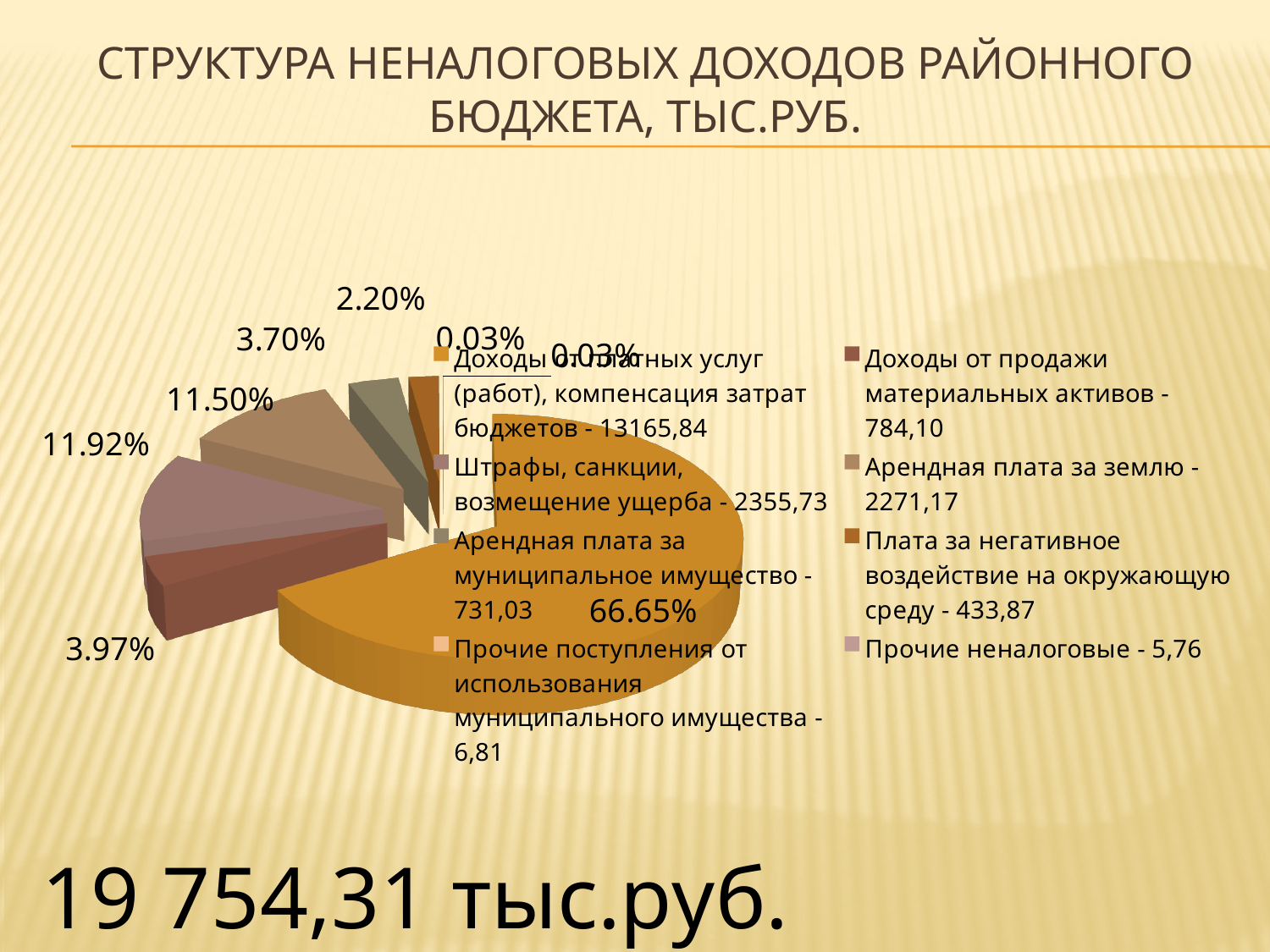
Which category has the smallest value in the legend? Прочие неналоговые - 5,76 What value is given in the legend for Штрафы, санкции, возмещение ущерба? 2355,73 How many categories does the legend of the pie chart list? 8 What is the title of the chart on the slide? Структура неналоговых доходов районного бюджета, тыс.руб. What value is given in the legend for Плата за негативное воздействие на окружающую среду? 433,87 Which category has the largest slice of the pie chart? Доходы от платных услуг (работ), компенсация затрат бюджетов What share of the pie does the largest slice (Доходы от платных услуг) have? 66.65% What total amount is printed at the bottom of the slide? 19 754,31 тыс.руб. What value is given in the legend for Арендная плата за землю? 2271,17 What kind of chart is shown on the slide? Pie chart Which is larger: Штрафы, санкции, возмещение ущерба or Арендная плата за землю? Штрафы, санкции, возмещение ущерба What is the difference between the values for Штрафы, санкции, возмещение ущерба (2355,73) and Арендная плата за землю (2271,17)? 84,56